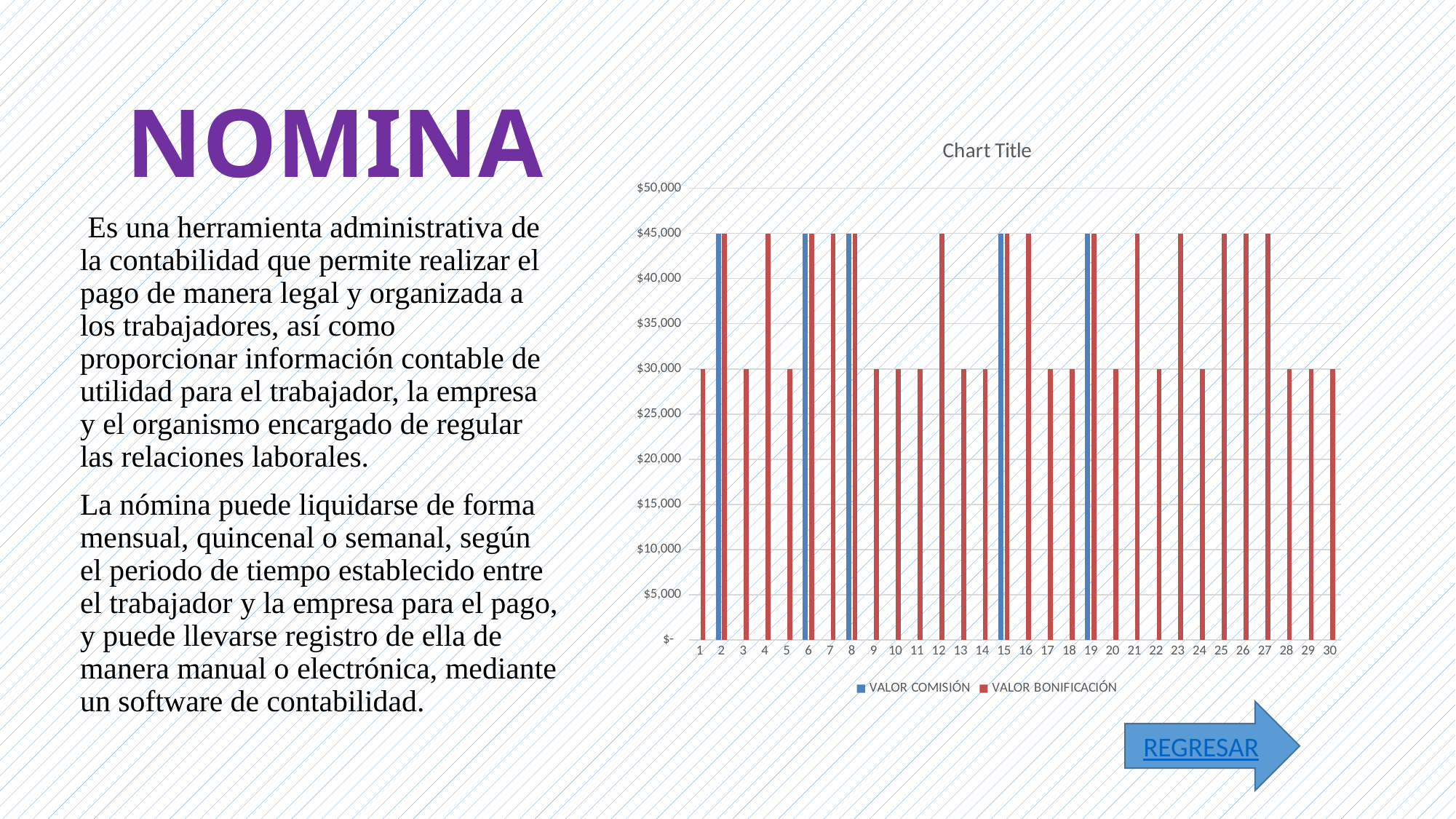
How many categories are shown along the x axis of the chart? 30 What is the VALOR BONIFICACIÓN value for category 1? $30,000 Which colour represents the VALOR COMISIÓN series in the chart? blue What kind of chart is shown on the slide? bar chart What is the VALOR BONIFICACIÓN value for category 4? $45,000 What is the difference between the VALOR BONIFICACIÓN values for category 2 and category 1? $15,000 Is the VALOR BONIFICACIÓN value for category 27 greater or less than $40,000? greater What is the VALOR COMISIÓN value for category 2? $45,000 How many series does the chart legend list? 2 What is the title of the chart? Chart Title Which is larger, the VALOR BONIFICACIÓN value for category 3 or for category 4? category 4 Is the VALOR BONIFICACIÓN value for category 9 greater or less than $40,000? less